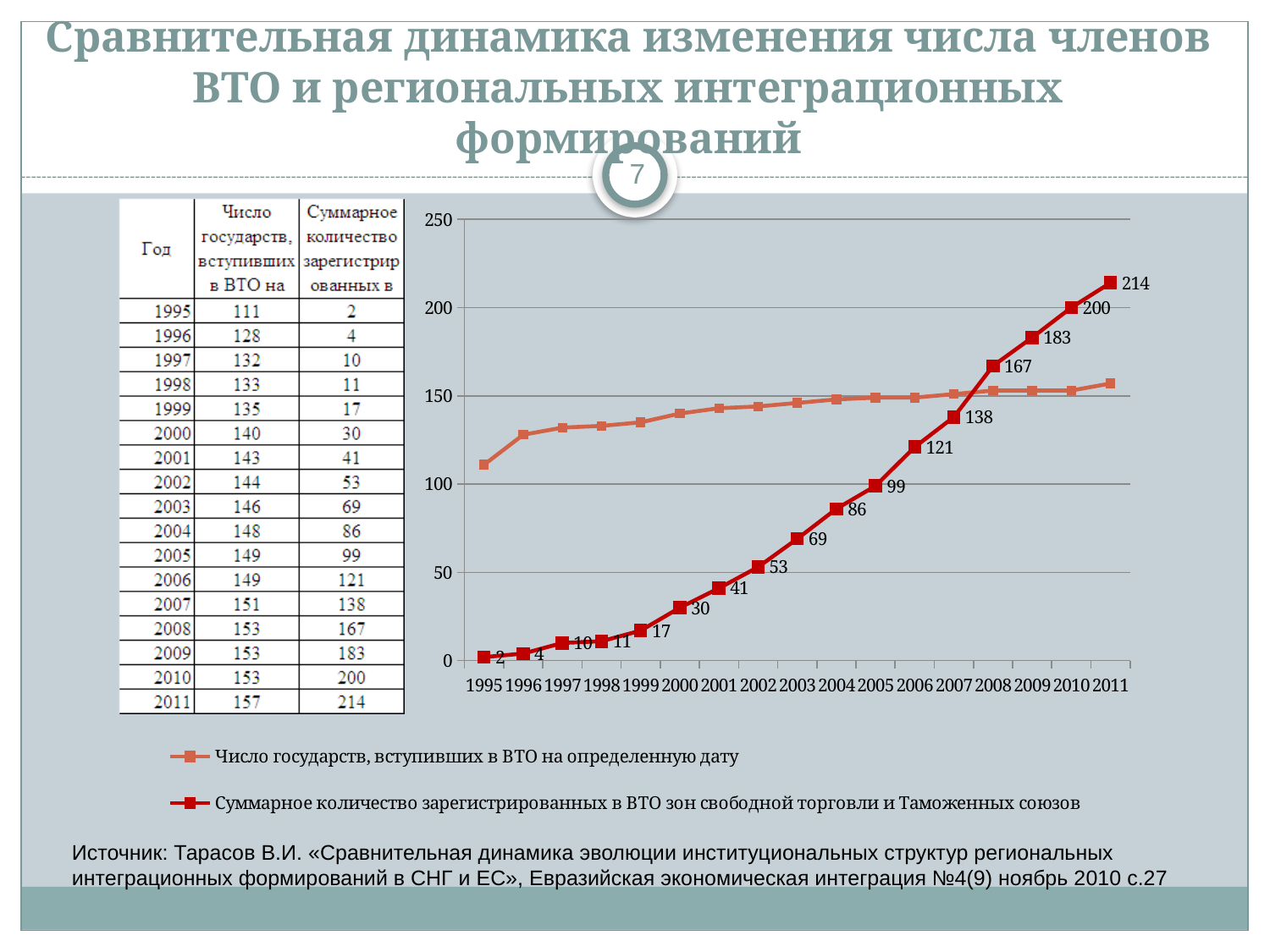
In which year is the red series at its highest? 2011 What is the value of the red series in 2000? 30 What is the cumulative number of registered free trade zones and customs unions (red series) in 2011? 214 Is the value of the orange series (Число государств, вступивших в ВТО) in 1995 greater or less than 100? greater By how much did the red series increase from 2010 to 2011? 14 Does the red series rise or fall from 1995 to 2011? rises How many years are plotted along the x axis of the chart? 17 How many series does the chart legend list? 2 What is the difference between the red series values in 2008 and 2007? 29 What is the value of the red series (Суммарное количество зарегистрированных в ВТО зон свободной торговли и Таможенных союзов) in 2005? 99 In which year is the red series at its lowest? 1995 What type of chart is shown on the slide? line chart